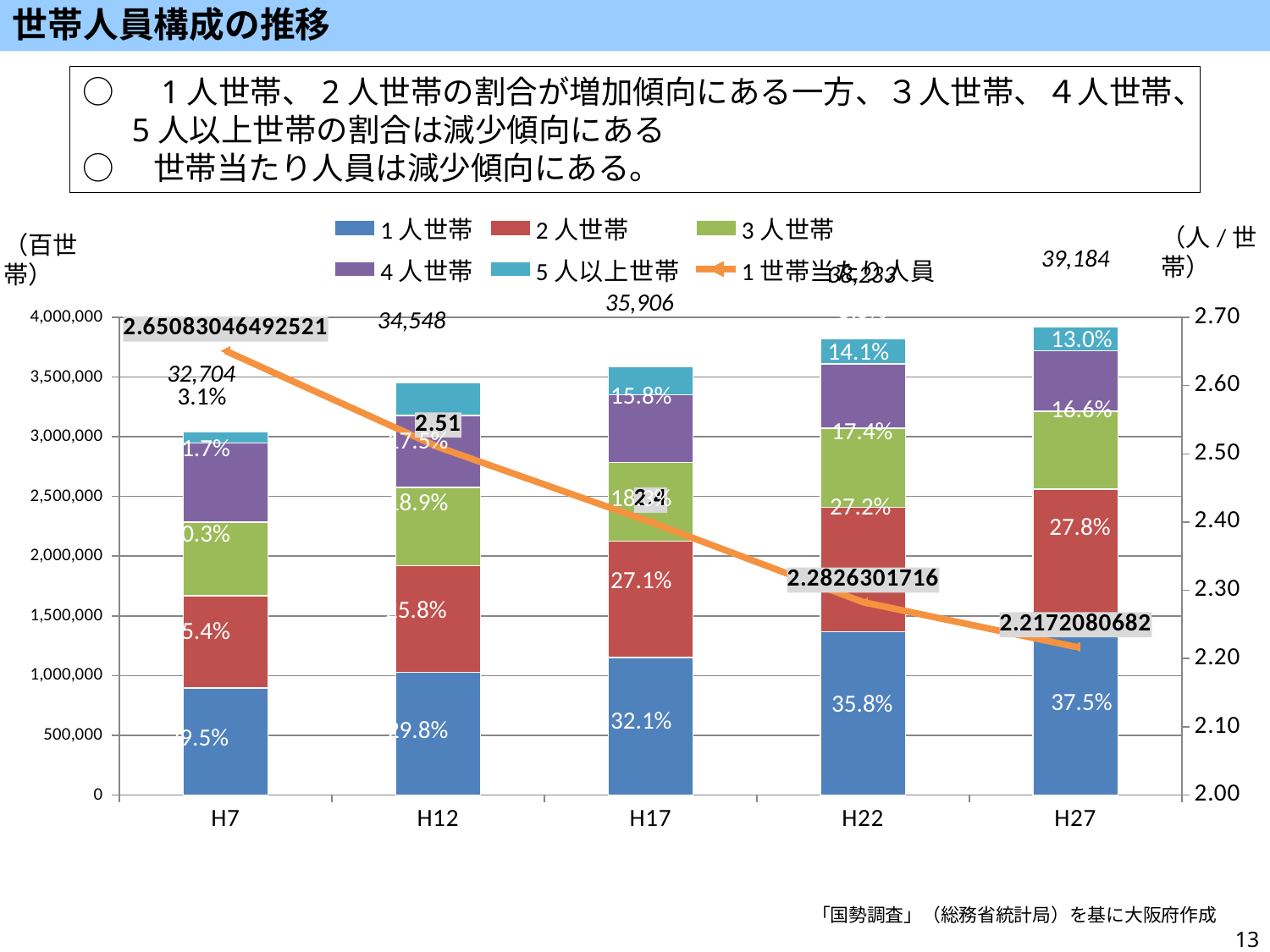
What is the share of 1人世帯 in H22? 35.8% What is the share of 2人世帯 in H17? 27.1% What is the total number of households (label above the bar) for H7? 32,704 Does the 1世帯当たり人員 line rise or fall from H7 to H27? fall Which is larger, the share of 1人世帯 in H27 or in H22? H27 How many categories are shown on the x axis? 5 How many series does the legend list? 6 What is the share of 3人世帯 in H22? 17.4% What kind of chart is shown on the slide? stacked bar chart with a line What is the share of 5人以上世帯 in H27? 13.0% What is the total number of households (label above the bar) for H27? 39,184 What is the share of 1人世帯 in H27? 37.5%